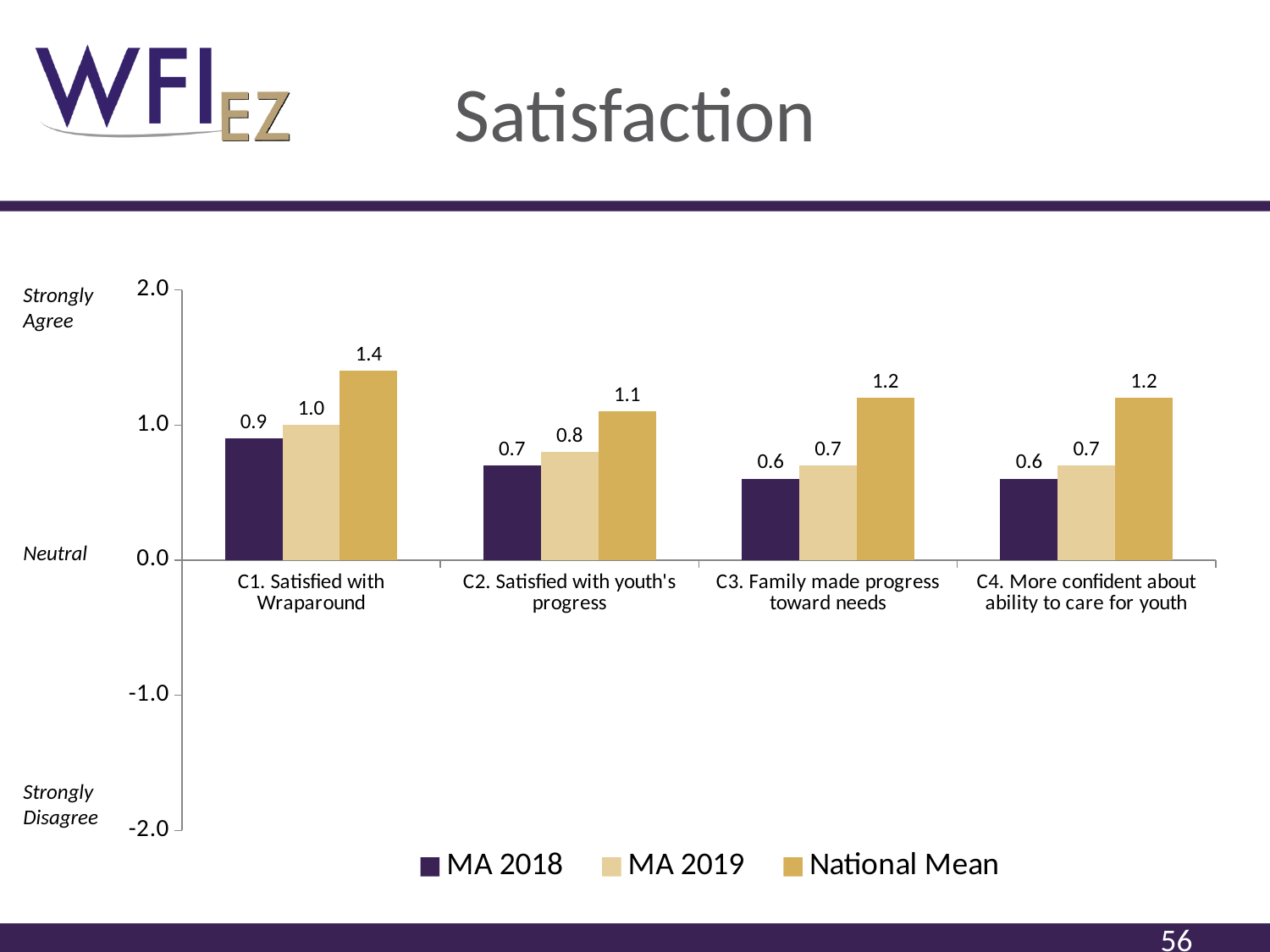
For C4. More confident about ability to care for youth, which is larger: MA 2019 or National Mean? National Mean How many series does the legend list? 3 What is the difference between the National Mean and MA 2018 values for C1. Satisfied with Wraparound? 0.5 What is the MA 2018 value for C1. Satisfied with Wraparound? 0.9 What kind of chart is shown on the slide? bar chart Is the National Mean value for C3. Family made progress toward needs greater or less than 1.0? greater What is the title of the slide? Satisfaction How many categories are shown on the x axis? 4 Which category has the highest National Mean value? C1. Satisfied with Wraparound What is the National Mean value for C2. Satisfied with youth's progress? 1.1 Which category has the lowest MA 2019 value? C3. Family made progress toward needs and C4. More confident about ability to care for youth (tied at 0.7) What is the MA 2019 value for C3. Family made progress toward needs? 0.7